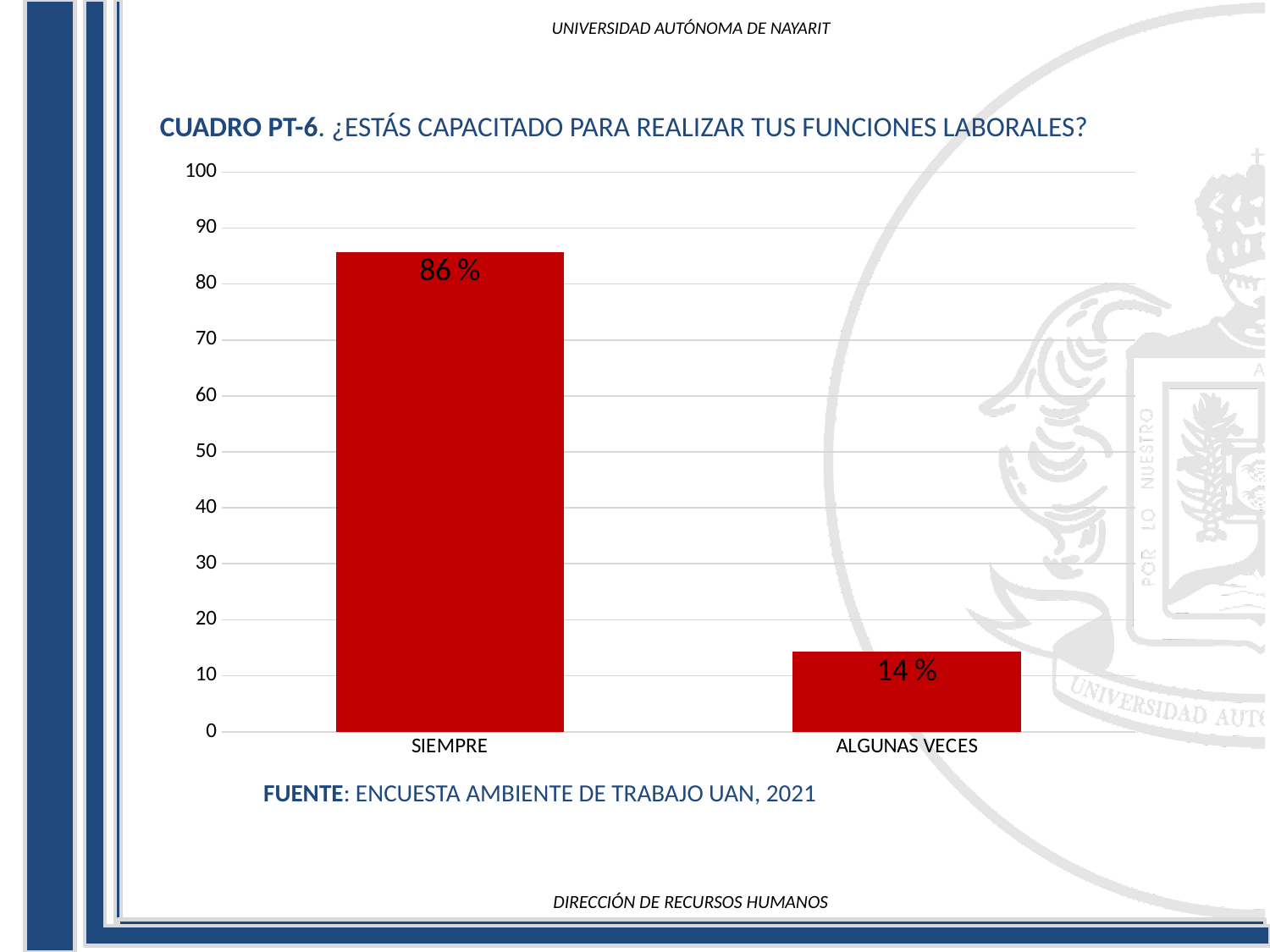
Which is larger, the value for SIEMPRE or the value for ALGUNAS VECES? SIEMPRE Is the value for ALGUNAS VECES greater or less than 20? less What is the value for ALGUNAS VECES? 14 % Which category has the highest value? SIEMPRE What is the value for SIEMPRE? 86 % What kind of chart is shown on the slide? bar chart Is the value for SIEMPRE greater or less than 80? greater What source is cited below the chart? ENCUESTA AMBIENTE DE TRABAJO UAN, 2021 How many categories are shown in the chart? 2 What is the title of the chart? CUADRO PT-6. ¿ESTÁS CAPACITADO PARA REALIZAR TUS FUNCIONES LABORALES? Which category has the lowest value? ALGUNAS VECES What is the difference between the values for SIEMPRE and ALGUNAS VECES? 72 %